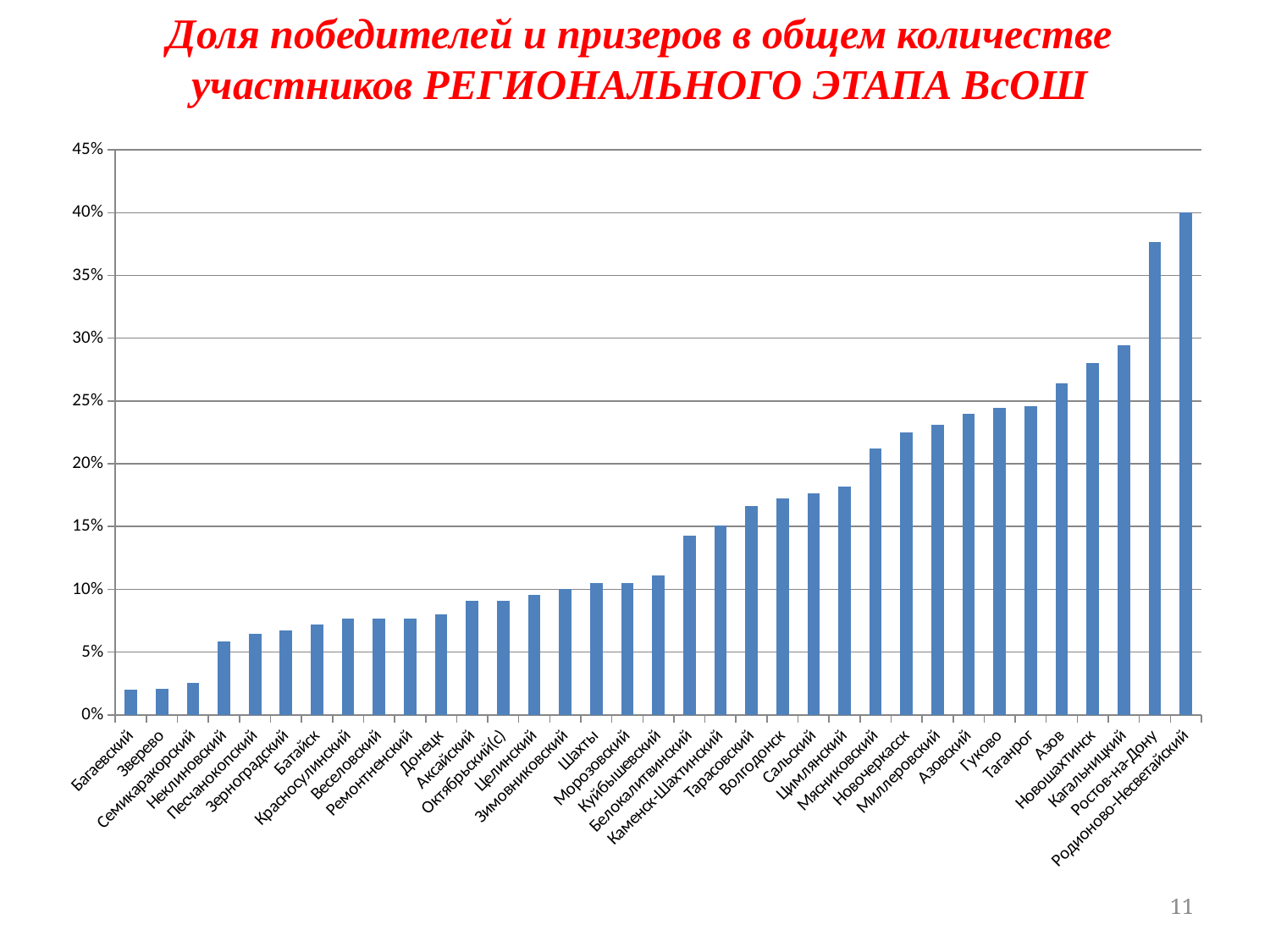
Which is larger, the value for Батайск or the value for Шахты? Шахты Which is larger, the value for Азов or the value for Гуково? Азов What is the maximum value shown on the vertical axis? 45% How many categories (municipalities) are shown on the x axis? 35 What kind of chart is shown on the slide? bar chart Is the value for Белокалитвинский greater or less than 15%? less Is the value for Ростов-на-Дону greater or less than 35%? greater Is the value for Кагальницкий greater or less than 30%? less Which category has the highest value? Родионово-Несветайский Do the values rise or fall from left to right along the x axis? rise